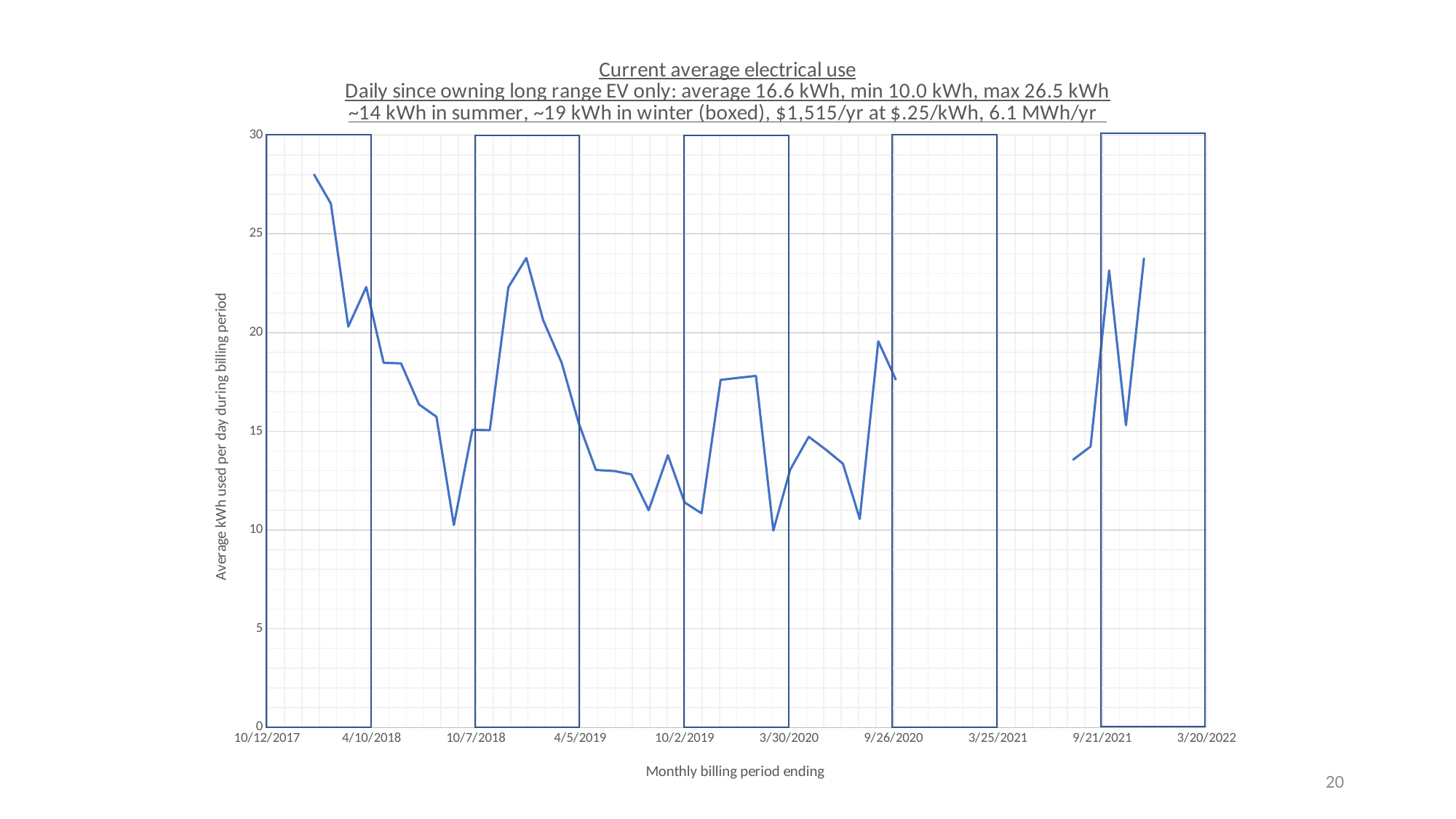
According to the chart title, what is the maximum daily electrical use? 26.5 kWh Do the values generally rise or fall from the first point to the billing period ending 10/7/2018? fall Is the highest point on the line greater or less than 25? greater What is the title of the y axis? Average kWh used per day during billing period What is the title of the x axis? Monthly billing period ending According to the chart title, what is the annual electricity cost at $.25/kWh? $1,515/yr Is the last plotted value on the line greater or less than 20? greater According to the chart title, what is the average daily electrical use since owning the long range EV only? 16.6 kWh According to the chart title, what is the minimum daily electrical use? 10.0 kWh What kind of chart is shown on the slide? line chart Is the value at the billing period ending 3/30/2020 greater or less than 15? less